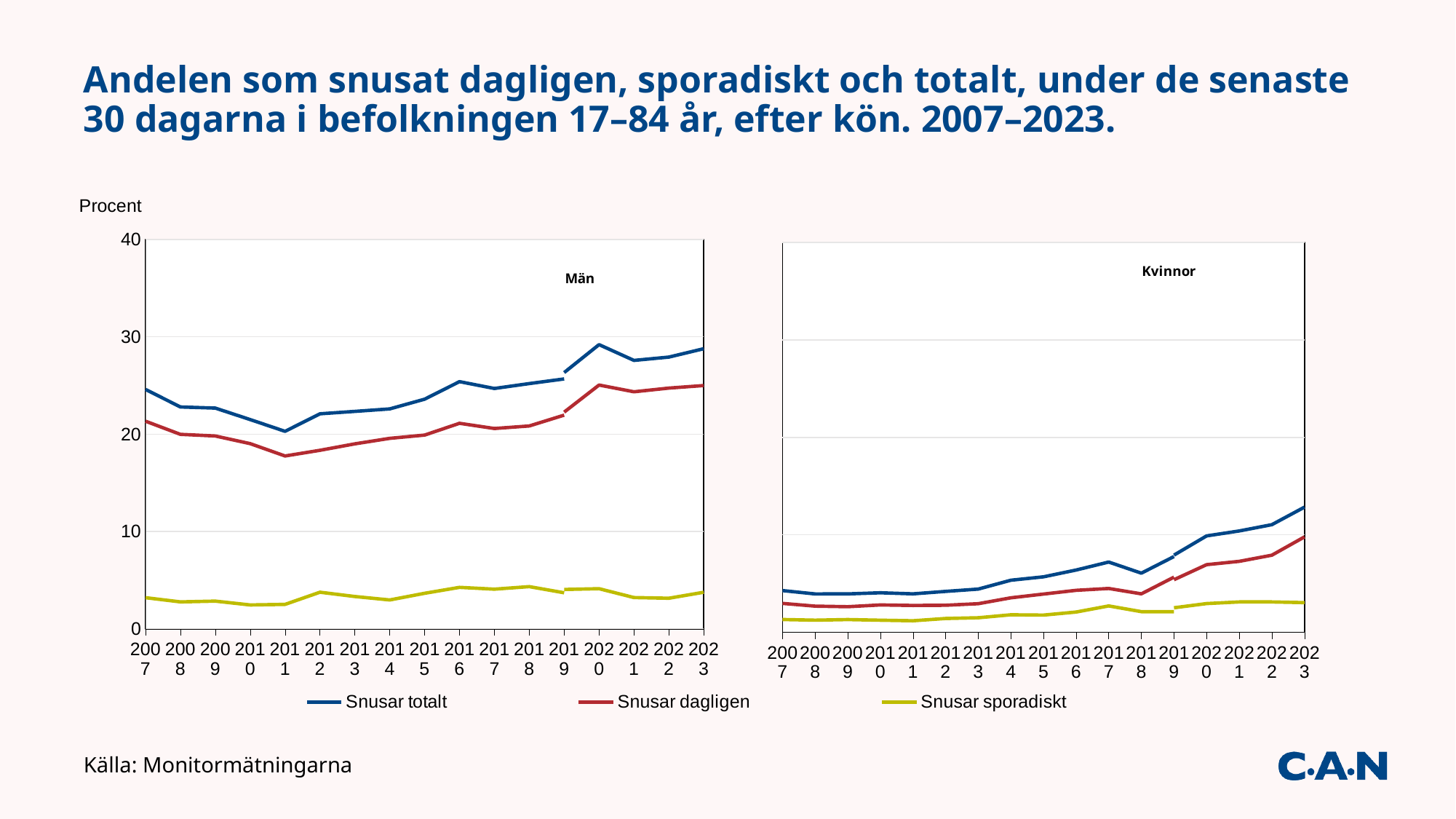
In the Män chart, is the value for Snusar totalt in 2023 greater or less than 20? greater In the Kvinnor chart, is the value for Snusar totalt in 2007 greater or less than 10? less In the Kvinnor chart, does the Snusar totalt line rise or fall from 2007 to 2023? Rise What kind of chart is used on this slide? Line chart How many series does the legend list? 3 In the Kvinnor chart, is the value for Snusar totalt in 2023 greater or less than 10? greater In the Män chart, how many years are plotted along the x axis? 17 Which is larger in 2023: Snusar totalt in the Män chart or Snusar totalt in the Kvinnor chart? Män In the Män chart, which series has the lowest values across all years? Snusar sporadiskt In the Kvinnor chart, in which year is Snusar totalt at its highest? 2023 In the Män chart, in which year is Snusar totalt at its lowest? 2011